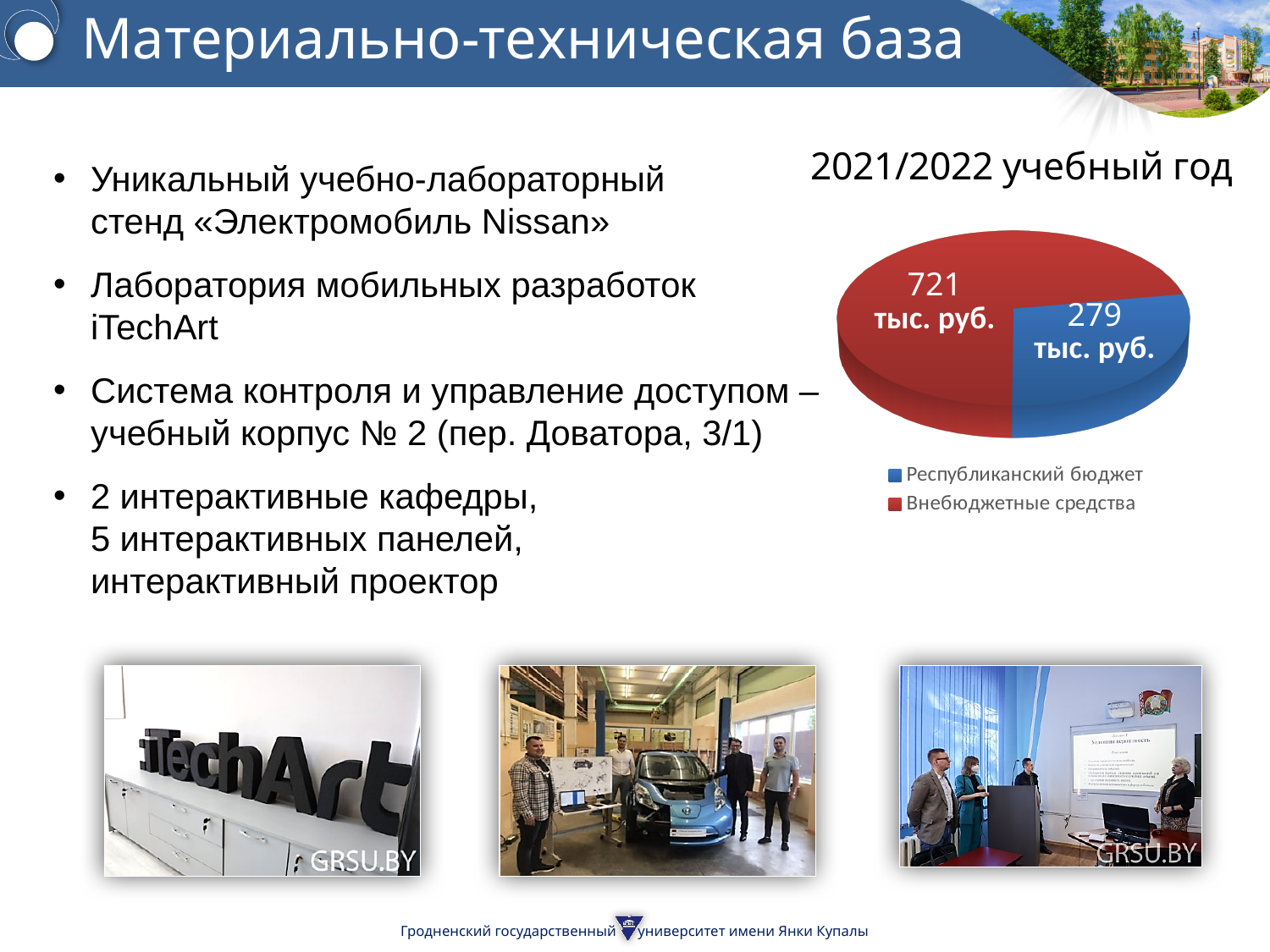
What is the value for Внебюджетные средства in the pie chart? 721 тыс. руб. Which category has the smallest slice in the pie chart? Республиканский бюджет Which category has the largest slice in the pie chart? Внебюджетные средства What is the title above the pie chart? 2021/2022 учебный год How many entries does the legend of the pie chart list? 2 What is the difference between Внебюджетные средства and Республиканский бюджет? 442 тыс. руб. What is the value for Республиканский бюджет in the pie chart? 279 тыс. руб. What is the total of the two slices in the pie chart? 1000 тыс. руб. Which is larger: Республиканский бюджет or Внебюджетные средства? Внебюджетные средства What share of the pie does Внебюджетные средства represent? 72.1% How many slices does the pie chart have? 2 What type of chart is shown on the slide? pie chart